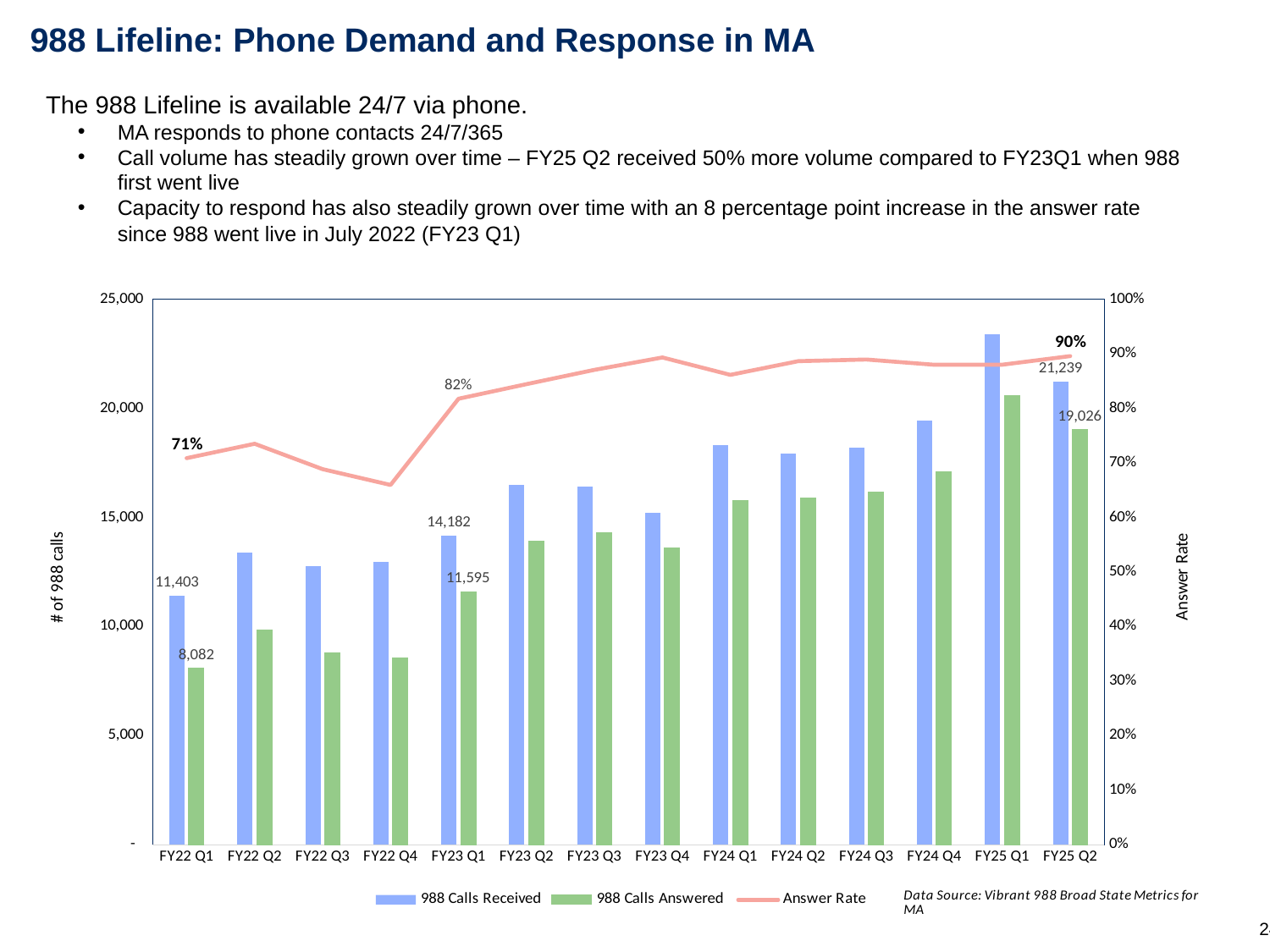
What was the answer rate in FY25 Q2? 90% What was the answer rate in FY23 Q1? 82% Which quarter had the highest number of 988 calls received? FY25 Q1 How many calls were received in FY22 Q1? 11,403 Which is larger: calls received in FY25 Q1 or calls received in FY25 Q2? FY25 Q1 How many quarters are shown on the x axis? 14 How many series does the legend list? 3 Which quarter had the lowest number of 988 calls answered? FY22 Q1 Is the number of 988 calls received in FY24 Q1 greater or less than 15,000? greater How many calls were answered in FY25 Q2? 19,026 What is the difference between calls received and calls answered in FY22 Q1? 3,321 How many more calls were received in FY25 Q2 than in FY22 Q1? 9,836